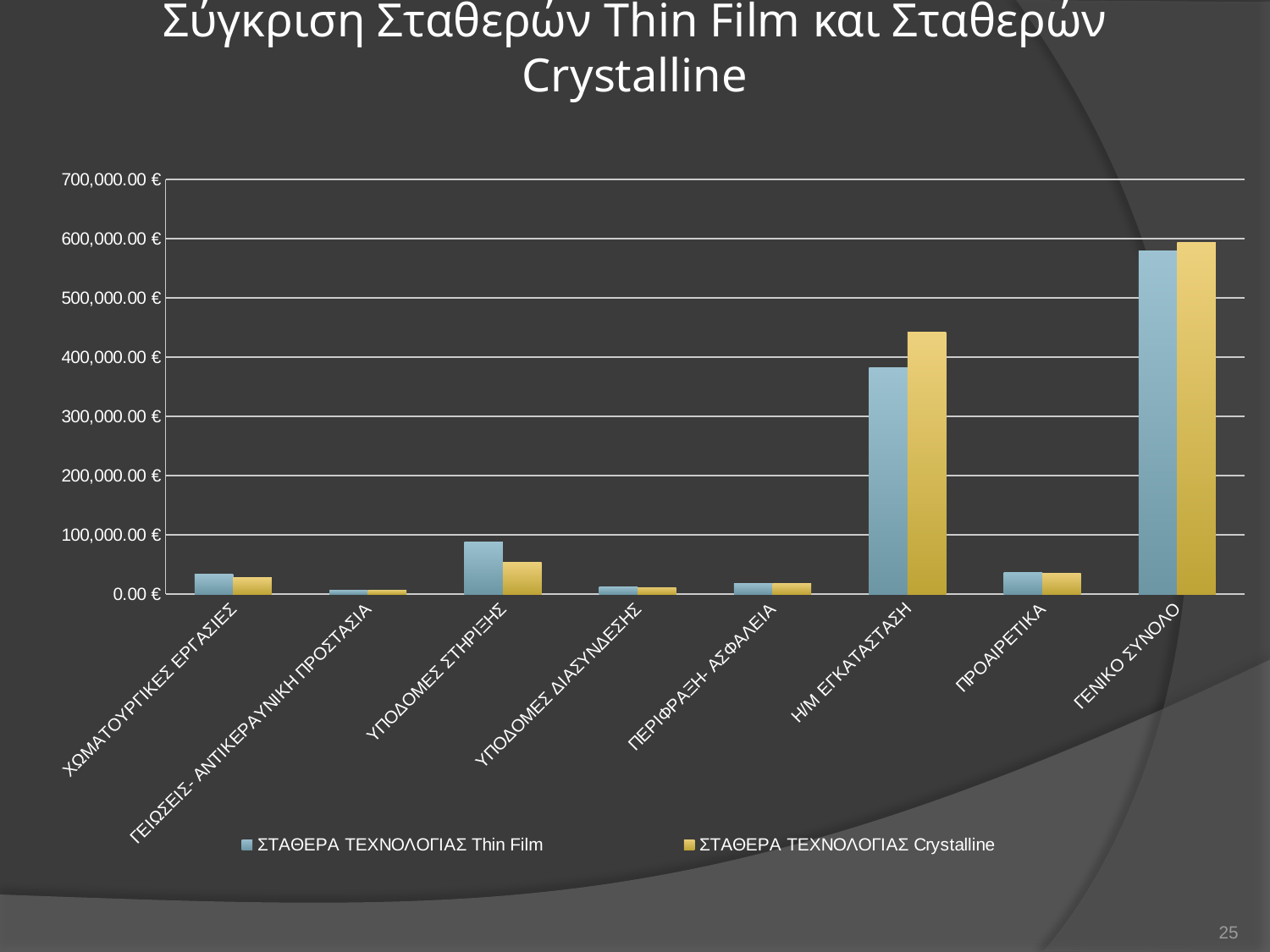
Which category has the lowest value for ΣΤΑΘΕΡΑ ΤΕΧΝΟΛΟΓΙΑΣ Thin Film? ΓΕΙΩΣΕΙΣ- ΑΝΤΙΚΕΡΑΥΝΙΚΗ ΠΡΟΣΤΑΣΙΑ Is the ΣΤΑΘΕΡΑ ΤΕΧΝΟΛΟΓΙΑΣ Thin Film value for ΥΠΟΔΟΜΕΣ ΣΤΗΡΙΞΗΣ greater or less than 100,000.00 €? less Is the ΣΤΑΘΕΡΑ ΤΕΧΝΟΛΟΓΙΑΣ Crystalline value for Η/Μ ΕΓΚΑΤΑΣΤΑΣΗ greater or less than 400,000.00 €? greater Is the ΣΤΑΘΕΡΑ ΤΕΧΝΟΛΟΓΙΑΣ Thin Film value for Η/Μ ΕΓΚΑΤΑΣΤΑΣΗ greater or less than 400,000.00 €? less For ΥΠΟΔΟΜΕΣ ΣΤΗΡΙΞΗΣ, which series has the larger value, Thin Film or Crystalline? ΣΤΑΘΕΡΑ ΤΕΧΝΟΛΟΓΙΑΣ Thin Film How many series does the legend list? 2 Which colour represents the ΣΤΑΘΕΡΑ ΤΕΧΝΟΛΟΓΙΑΣ Crystalline series? yellow Which category has the highest value for ΣΤΑΘΕΡΑ ΤΕΧΝΟΛΟΓΙΑΣ Crystalline? ΓΕΝΙΚΟ ΣΥΝΟΛΟ How many categories are shown on the x axis? 8 For Η/Μ ΕΓΚΑΤΑΣΤΑΣΗ, which series has the larger value, Thin Film or Crystalline? ΣΤΑΘΕΡΑ ΤΕΧΝΟΛΟΓΙΑΣ Crystalline What kind of chart is shown on the slide? bar chart